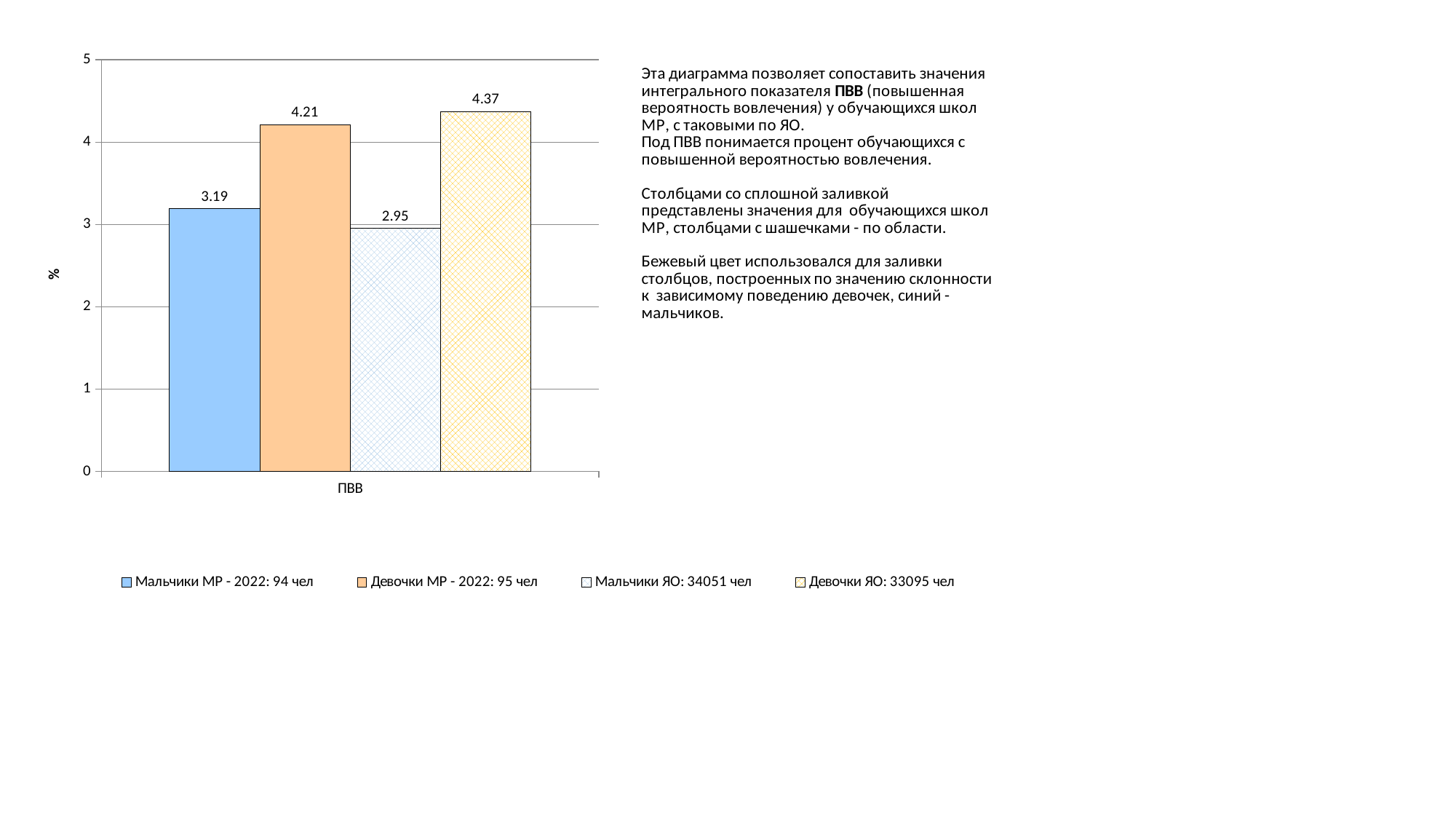
Which is larger, the value for 'Мальчики МР - 2022: 94 чел' or for 'Девочки МР - 2022: 95 чел'? Девочки МР - 2022: 95 чел How many series does the legend list? 4 What is the value for the series 'Мальчики ЯО: 34051 чел'? 2.95 What is the difference between the values for 'Девочки ЯО: 33095 чел' and 'Девочки МР - 2022: 95 чел'? 0.16 Which series has the lowest value? Мальчики ЯО: 34051 чел What is the value for the series 'Девочки ЯО: 33095 чел'? 4.37 What is the difference between the values for 'Мальчики МР - 2022: 94 чел' and 'Мальчики ЯО: 34051 чел'? 0.24 What is the value for the series 'Девочки МР - 2022: 95 чел'? 4.21 Which series has the highest value? Девочки ЯО: 33095 чел What kind of chart is shown on the slide? Bar chart What is the label of the category on the x axis? ПВВ What is the value for the series 'Мальчики МР - 2022: 94 чел'? 3.19